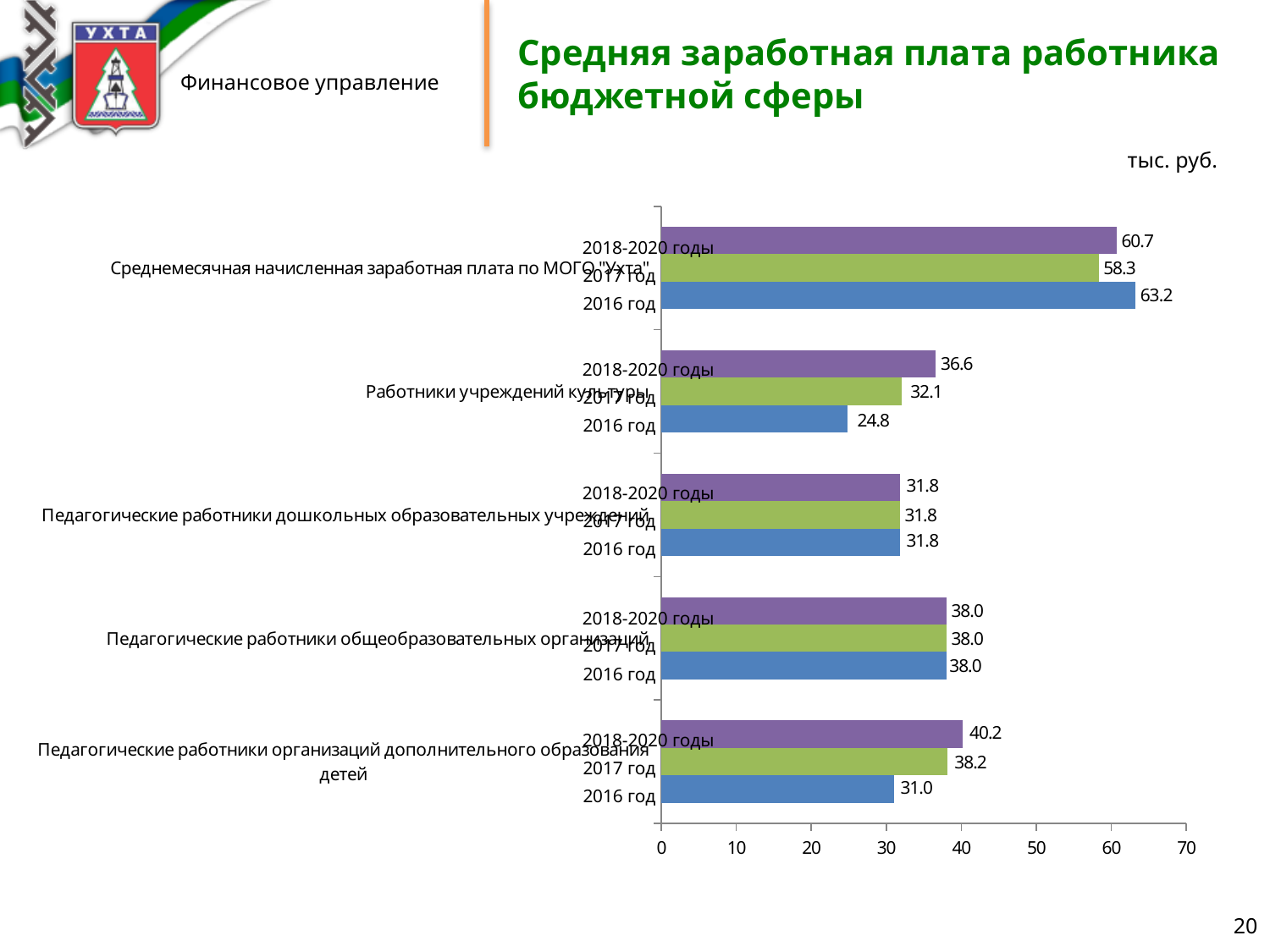
Which year has the lowest value in the category "Работники учреждений культуры"? 2016 год What is the value for 2018-2020 годы in the category "Работники учреждений культуры"? 36.6 How many categories of workers are shown on the chart? 5 Is the 2017 год value for "Среднемесячная начисленная заработная плата по МОГО "Ухта"" greater or less than 50? greater What is the value for 2016 год in the category "Педагогические работники дошкольных образовательных учреждений"? 31.8 What type of chart is shown on the slide? bar chart What is the value for 2017 год in the category "Педагогические работники организаций дополнительного образования детей"? 38.2 What is the difference between the 2018-2020 годы and 2016 год values for "Работники учреждений культуры"? 11.8 What is the value for 2016 год in the category "Среднемесячная начисленная заработная плата по МОГО "Ухта""? 63.2 Do the values for "Педагогические работники организаций дополнительного образования детей" rise or fall from 2016 год to 2018-2020 годы? rise Which is larger: the 2018-2020 годы value for "Педагогические работники организаций дополнительного образования детей" or the 2018-2020 годы value for "Педагогические работники общеобразовательных организаций"? Педагогические работники организаций дополнительного образования детей Which year has the highest value in the category "Среднемесячная начисленная заработная плата по МОГО "Ухта""? 2016 год